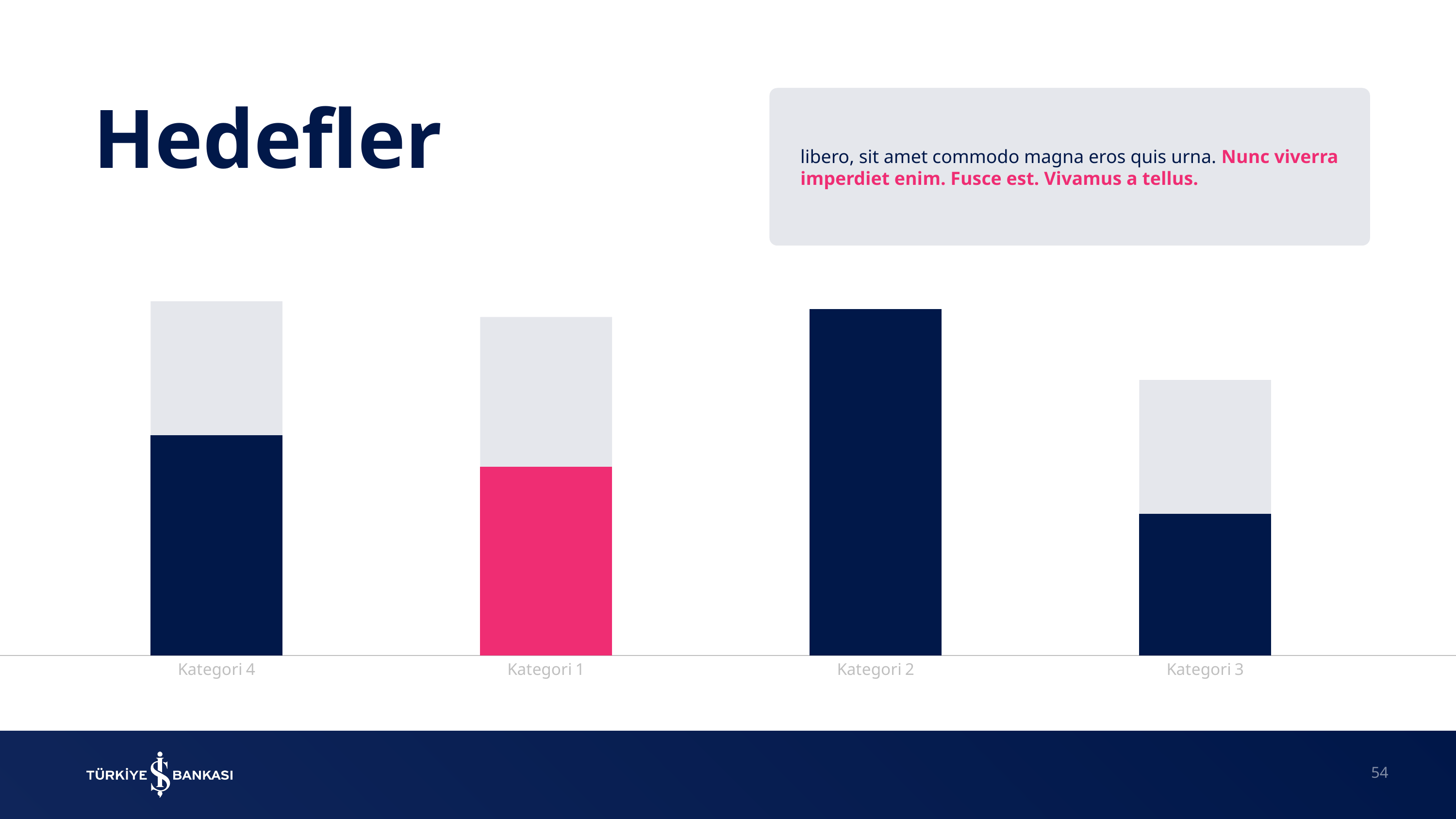
Which category's bar is coloured pink in the chart? Kategori 1 Is the coloured segment for Kategori 4 taller or shorter than the coloured segment for Kategori 1? taller Which category has the smallest coloured (non-grey) segment in the chart? Kategori 3 How many categories are shown on the x axis of the chart? 4 Which category has the tallest dark navy segment in the chart? Kategori 2 Which category has the shortest bar overall in the chart? Kategori 3 What is the title of the slide containing the chart? Hedefler Is the overall bar for Kategori 1 taller or shorter than the overall bar for Kategori 3? taller Which category label appears first (leftmost) on the x axis? Kategori 4 What kind of chart is shown on the slide? bar chart